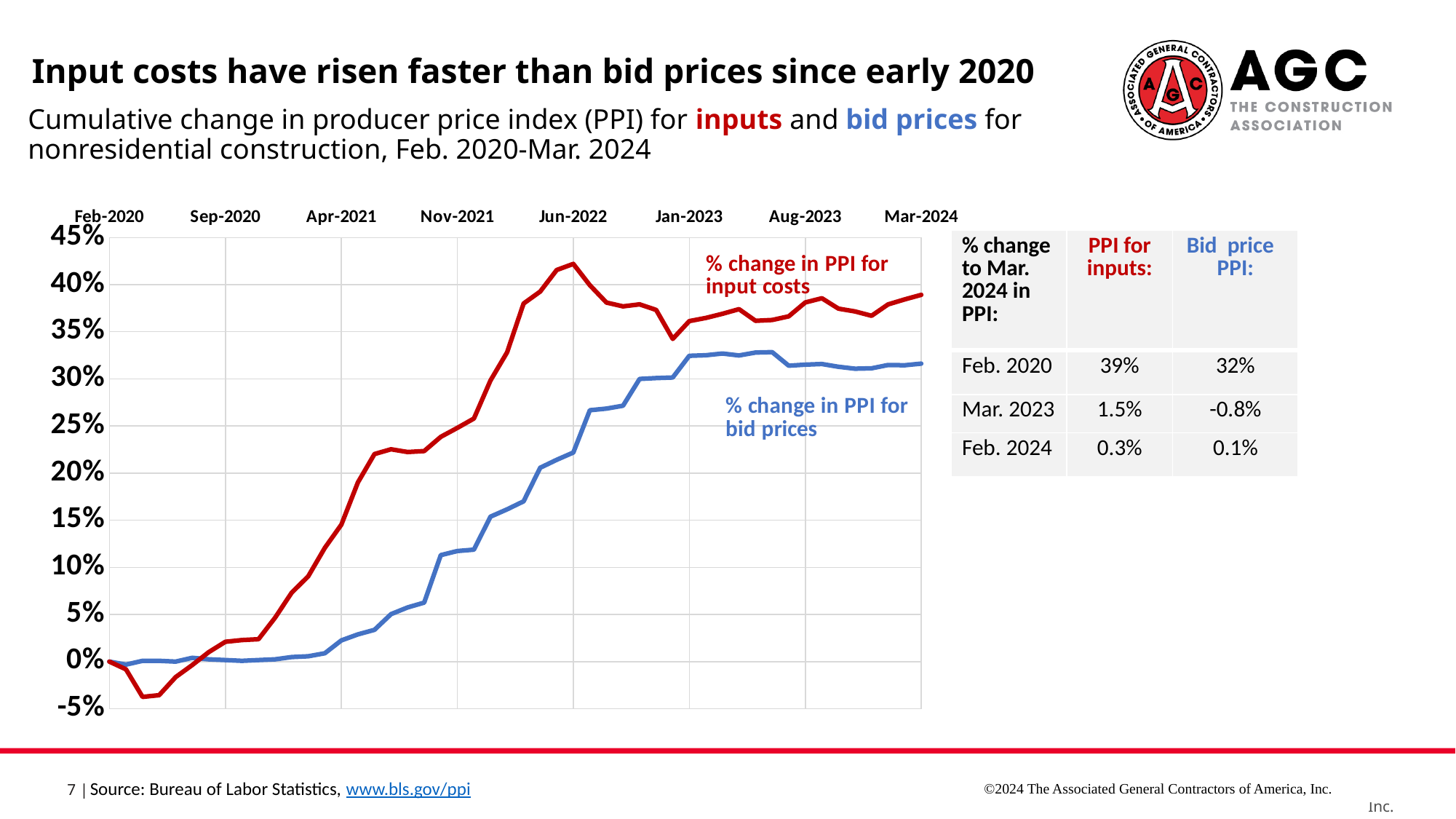
Is the value for % change in PPI for input costs at Sep-2020 greater or less than 5%? less What kind of chart is shown on the slide? line chart How many data series are plotted on the chart? 2 What colour is the line for % change in PPI for bid prices? blue According to the table on the slide, what is the % change in PPI for inputs from Feb. 2020 to Mar. 2024? 39% At Mar-2024, which series has the larger value, PPI for input costs or PPI for bid prices? % change in PPI for input costs Is the value for % change in PPI for bid prices at Apr-2021 greater or less than 5%? less Is the peak value of the % change in PPI for input costs (around Jun-2022) greater or less than 40%? greater Which series reaches the higher peak value on the chart, PPI for input costs or PPI for bid prices? % change in PPI for input costs Does the % change in PPI for bid prices rise or fall overall from Feb-2020 to Mar-2024? rise How many date labels are shown along the x axis of the chart? 8